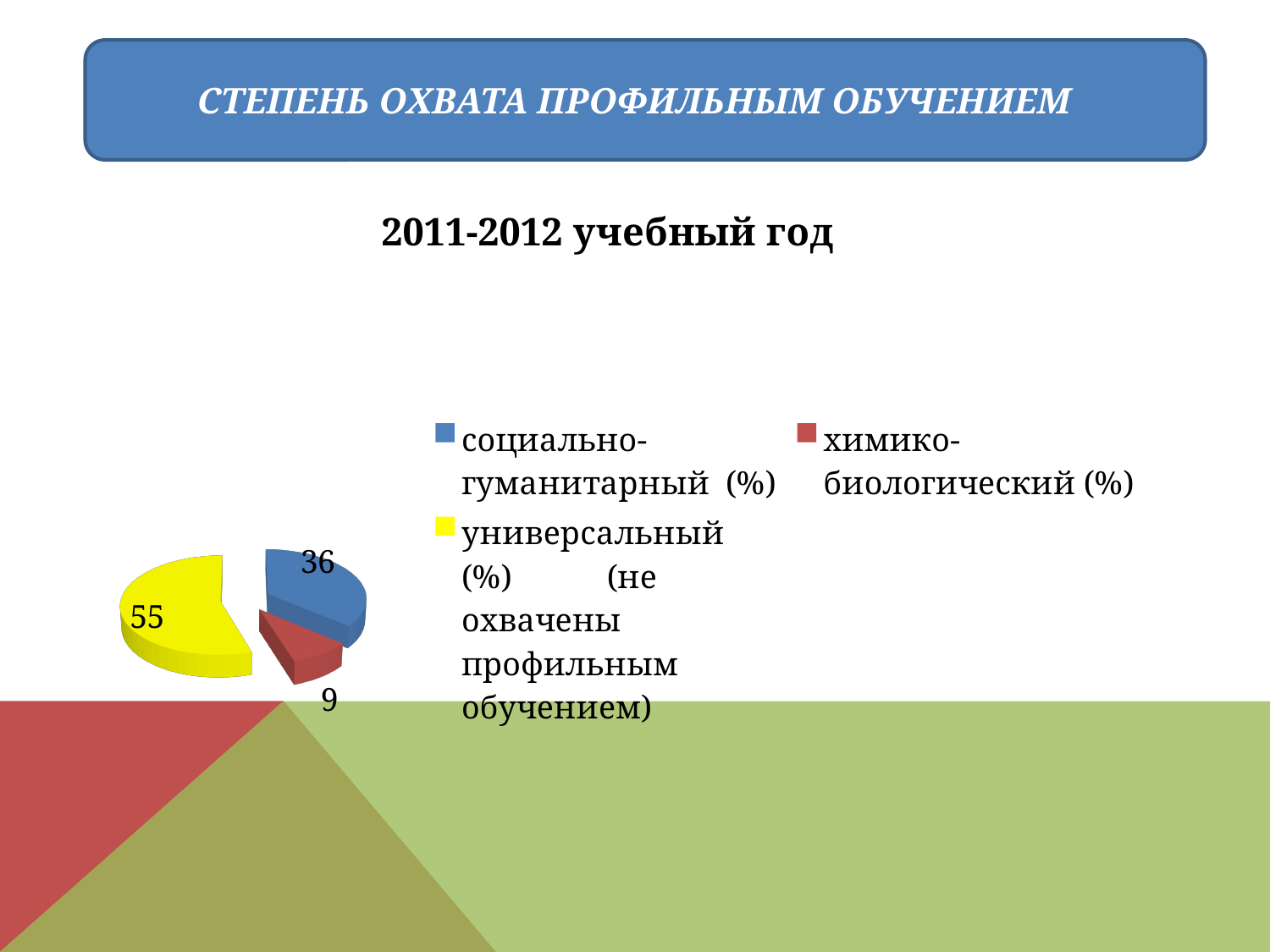
Which is larger: the value for социально-гуманитарный or the value for химико-биологический? социально-гуманитарный What colour is the slice for химико-биологический (%) in the pie chart? red What is the value for химико-биологический (%) in the pie chart? 9 What kind of chart is shown on the slide? pie chart What is the value for универсальный (%) (не охвачены профильным обучением) in the pie chart? 55 What is the difference between the values for универсальный and социально-гуманитарный? 19 What is the difference between the values for социально-гуманитарный and химико-биологический? 27 How many slices does the pie chart have? 3 Which category has the smallest slice in the pie chart? химико-биологический (%) What is the value for социально-гуманитарный (%) in the pie chart? 36 Which category has the largest slice in the pie chart? универсальный (%) (не охвачены профильным обучением) What is the title shown above the pie chart? 2011-2012 учебный год